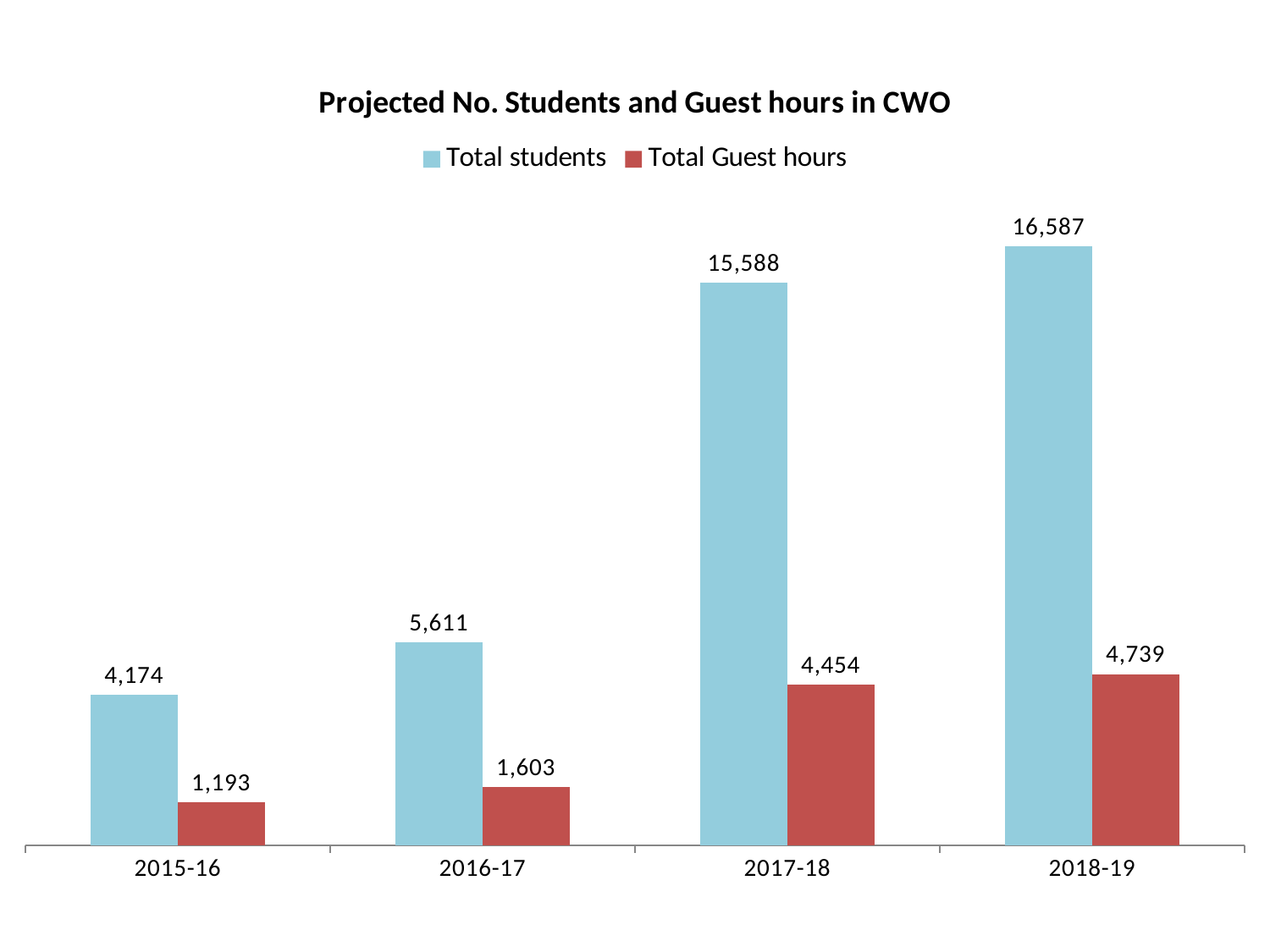
What kind of chart is shown on the slide? Bar chart How many years are shown on the x axis? 4 Which is larger: Total Guest hours in 2017-18 or Total students in 2016-17? Total students in 2016-17 Which year has the highest value for Total Guest hours? 2018-19 What is the value for Total students in 2017-18? 15,588 What is the difference between Total students and Total Guest hours in 2018-19? 11,848 Which year has the lowest value for Total students? 2015-16 What is the value for Total Guest hours in 2016-17? 1,603 What is the difference in Total students between 2016-17 and 2015-16? 1,437 Do the Total students values rise or fall from 2015-16 to 2018-19? Rise What is the value for Total students in 2015-16? 4,174 How many series does the legend list? 2